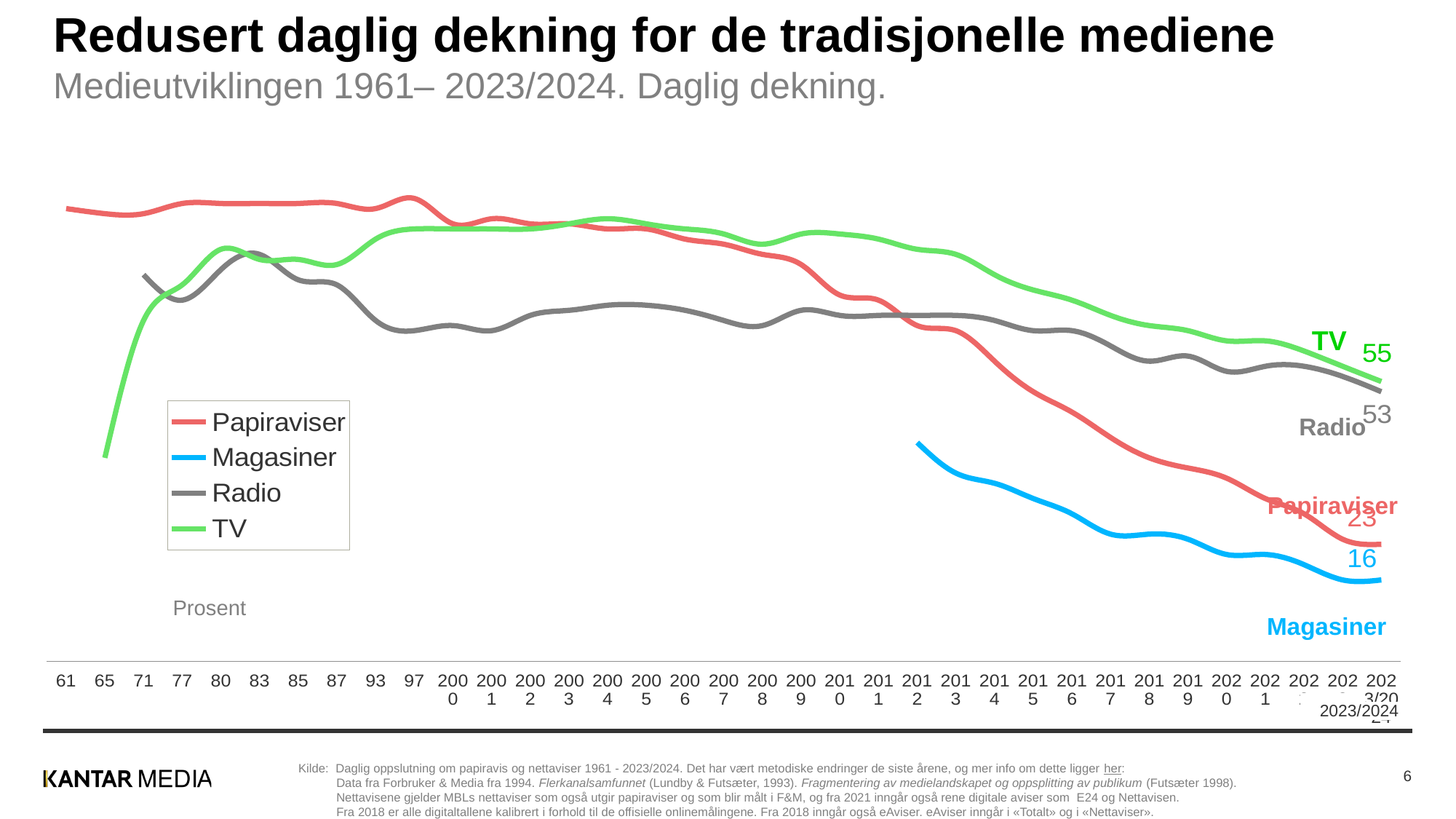
Does the Papiraviser line rise or fall from 2010 to 2023/2024? fall What type of chart is shown on the slide? line chart What colour is the Magasiner line? blue What is the value for Magasiner at the final point (2023/2024)? 16 What is the value for Papiraviser at the final point (2023/2024)? 23 What is the value for Radio at the final point (2023/2024)? 53 How many series does the legend list? 4 Which series has the lowest value at the final point (2023/2024)? Magasiner What is the value for TV at the final point (2023/2024)? 55 What is the difference between the final values of TV and Papiraviser? 32 Which series has the highest value at the final point (2023/2024)? TV At the final point, which is larger: Papiraviser or Magasiner? Papiraviser